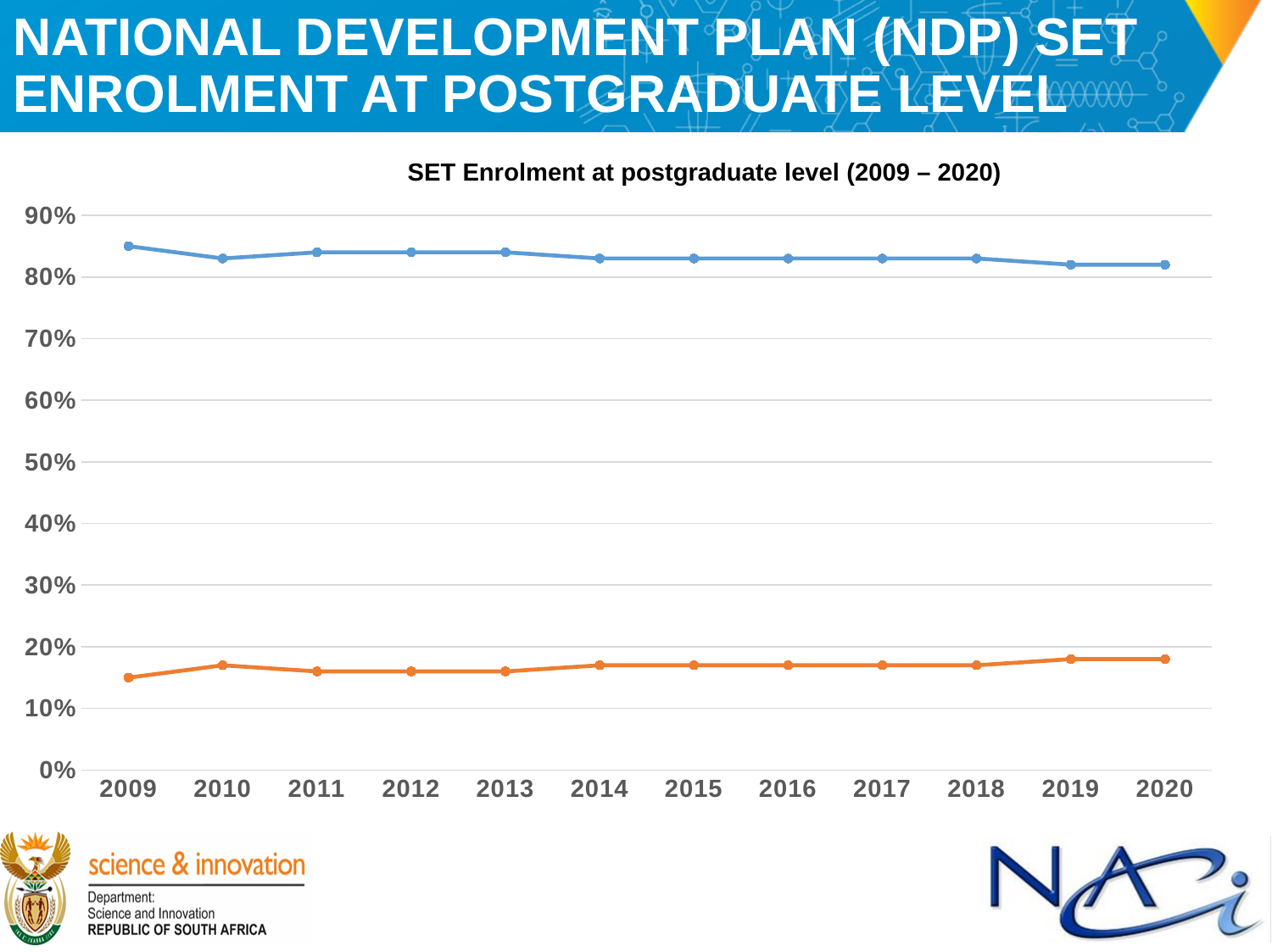
Is the value of the orange line for 2009 greater or less than 20%? less Is the value of the blue line for 2020 greater or less than 70%? greater How many years are plotted along the x axis of the chart? 12 What type of chart is shown on the slide? line chart Which line has the higher value in 2015, the blue line or the orange line? the blue line What is the title of the chart? SET Enrolment at postgraduate level (2009 – 2020) Does the blue line generally rise or fall from 2009 to 2020? fall In which year does the blue line reach its highest value? 2009 Is the value of the blue line for 2009 greater or less than 80%? greater In which year does the orange line have its lowest value? 2009 How many lines are plotted on the chart? 2